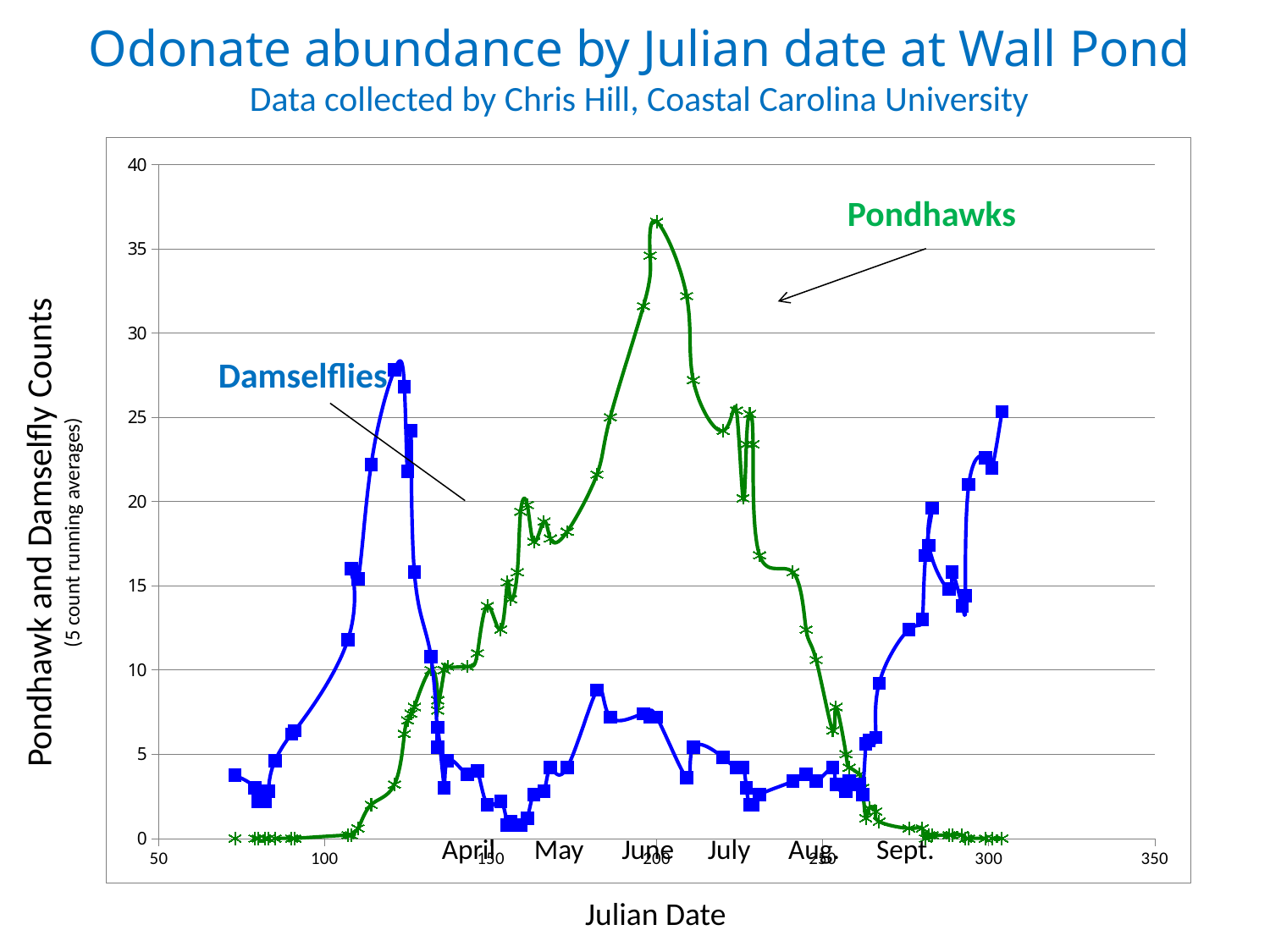
How many data series are plotted on the chart? 2 What colour is the Pondhawks line? green Is the Pondhawks value at Julian date 100 greater or less than 5? less Do the Pondhawks values rise or fall between Julian date 200 and Julian date 300? fall Is the peak value of the Damselflies series greater or less than 25? greater Is the Damselflies value at Julian date 300 greater or less than 20? greater At Julian date 200, which series has the larger value, Pondhawks or Damselflies? Pondhawks What is the label of the x axis? Julian Date Which series reaches the highest value on the chart? Pondhawks What kind of chart is shown on the slide? line chart At Julian date 300, which series has the larger value, Pondhawks or Damselflies? Damselflies